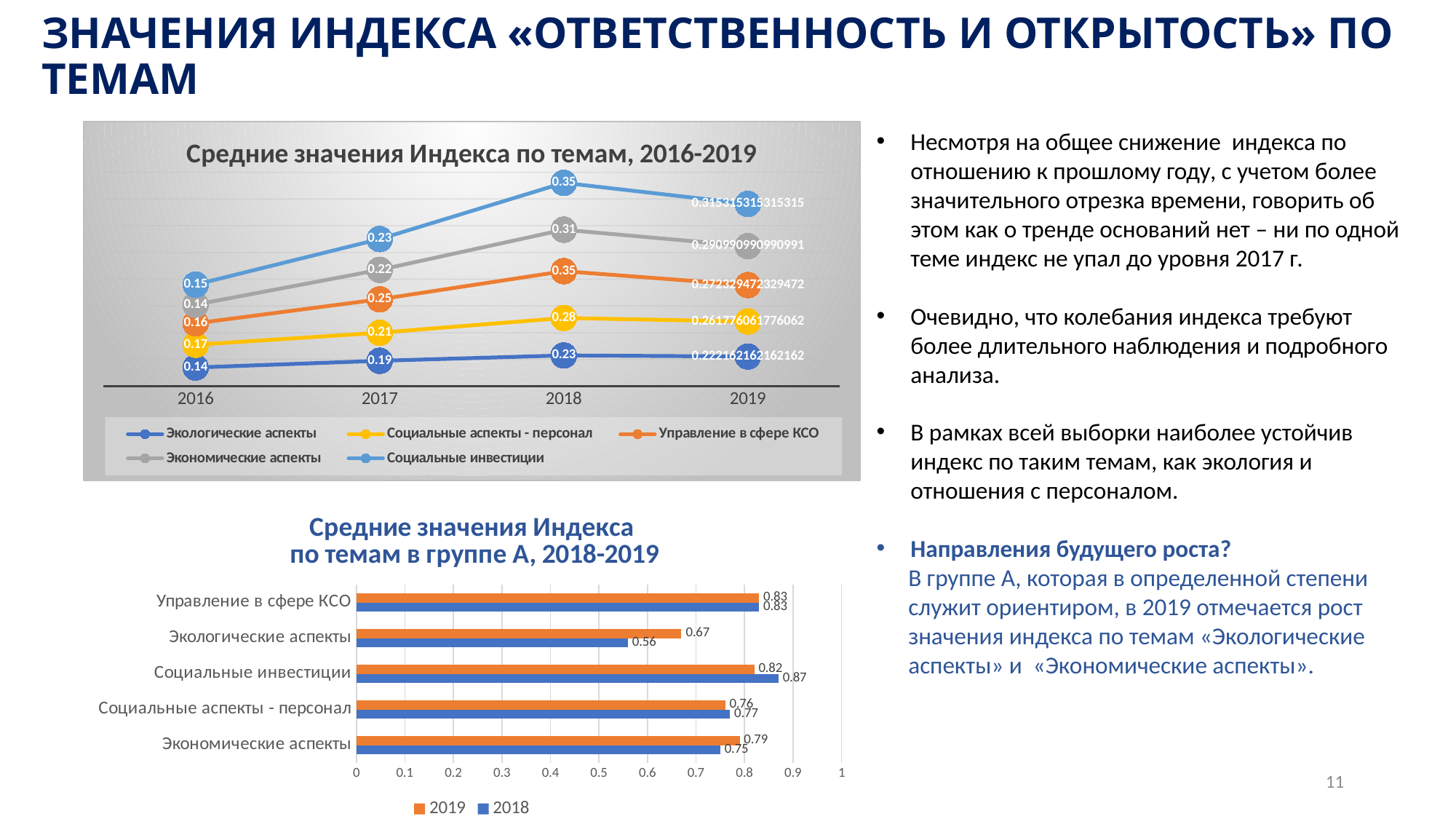
In the bottom chart 'Средние значения Индекса по темам в группе А, 2018-2019', what is the 2019 value for Экологические аспекты? 0.67 In the bottom chart 'Средние значения Индекса по темам в группе А, 2018-2019', is the 2019 value for Экономические аспекты larger or smaller than its 2018 value? Larger In the top chart 'Средние значения Индекса по темам, 2016-2019', what type of chart is shown? Line chart In the bottom chart 'Средние значения Индекса по темам в группе А, 2018-2019', what is the 2018 value for Социальные инвестиции? 0.87 In the top chart 'Средние значения Индекса по темам, 2016-2019', what is the difference between the Управление в сфере КСО values for 2018 and 2017? 0.10 In the top chart 'Средние значения Индекса по темам, 2016-2019', what is the value for Социальные инвестиции in 2018? 0.35 In the top chart 'Средние значения Индекса по темам, 2016-2019', what is the value for Экологические аспекты in 2017? 0.19 In the top chart 'Средние значения Индекса по темам, 2016-2019', how many series does the legend list? 5 In the bottom chart 'Средние значения Индекса по темам в группе А, 2018-2019', what is the difference between the 2019 and 2018 values for Экологические аспекты? 0.11 In the bottom chart 'Средние значения Индекса по темам в группе А, 2018-2019', how many categories are shown? 5 In the bottom chart 'Средние значения Индекса по темам в группе А, 2018-2019', which category has the lowest 2018 value? Экологические аспекты